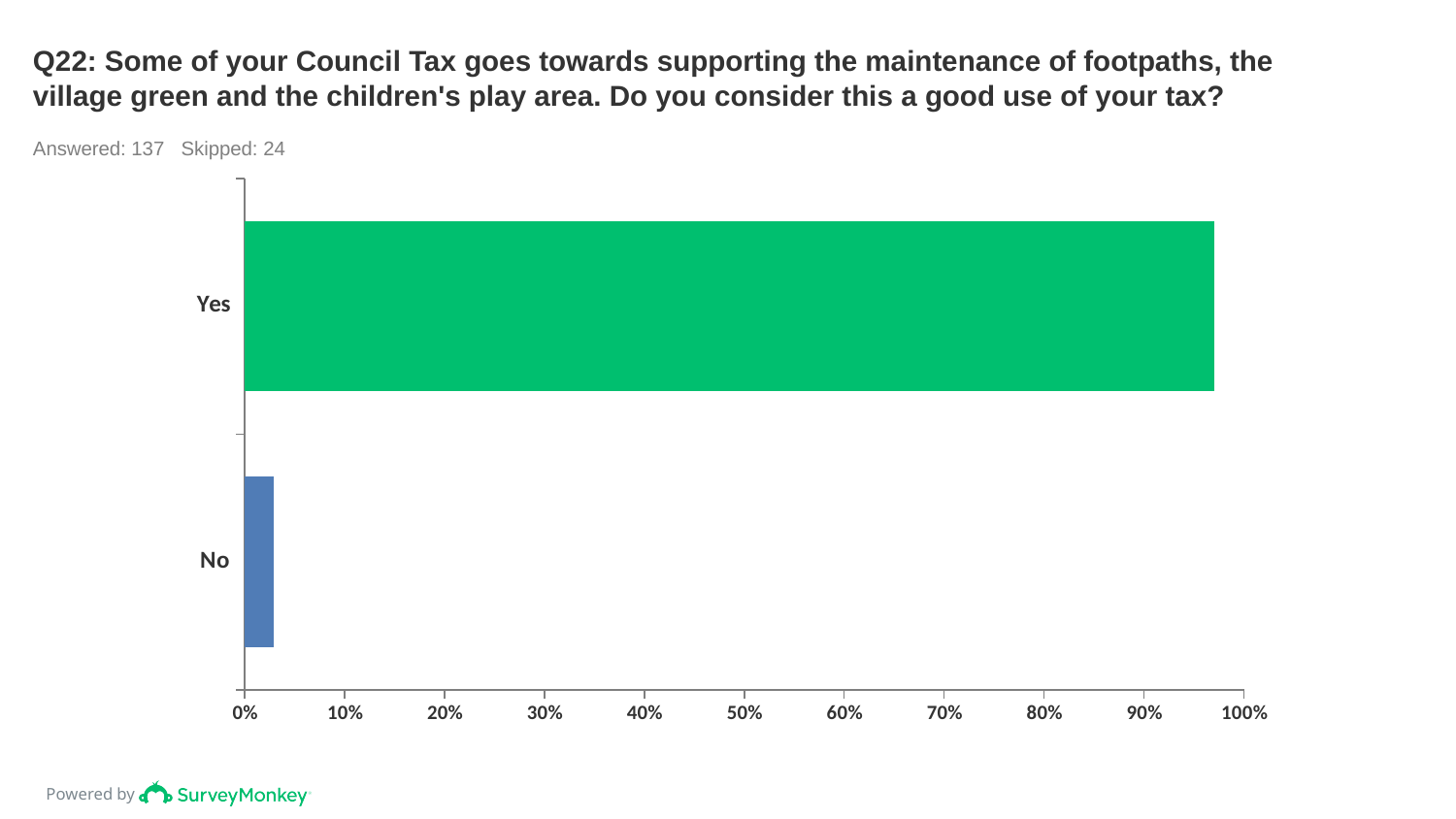
What is the highest value shown on the x axis? 100% Is the value for Yes greater or less than 90%? greater Which is larger, the value for Yes or the value for No? Yes What kind of chart is shown on the slide? bar chart Is the value for No greater or less than 10%? less Which category has the highest value? Yes How many respondents answered this question, according to the slide? 137 How many respondents skipped this question, according to the slide? 24 Which category has the lowest value? No Is the value for Yes greater or less than 50%? greater How many categories are plotted in the chart? 2